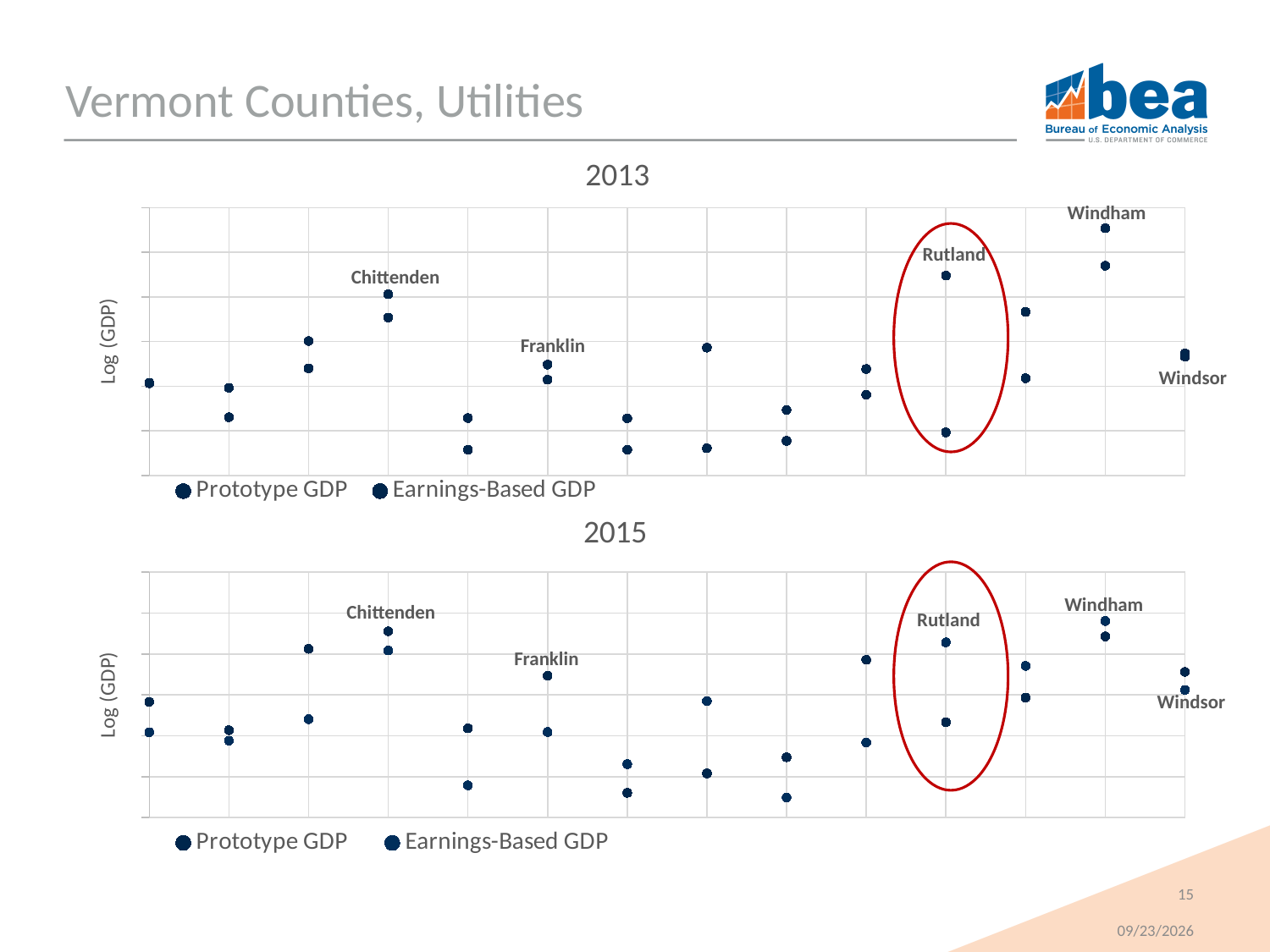
What is the title of the bottom chart? 2015 In the 2015 chart, which county's points are higher, Windham or Windsor? Windham What are the two series named in the legend of the 2013 chart? Prototype GDP and Earnings-Based GDP In the 2013 chart, which labeled county has the highest point? Windham How many counties (x-axis positions) are plotted in the 2013 chart? 14 What is the y-axis label of the 2015 chart? Log (GDP) What kind of chart is the 2013 chart? Scatter chart In the 2013 chart, which county's points are higher, Chittenden or Windsor? Chittenden In the 2013 chart, which county's points are higher, Chittenden or Franklin? Chittenden In the 2015 chart, which labeled county has the highest point? Windham How many series does the legend of the 2015 chart list? 2